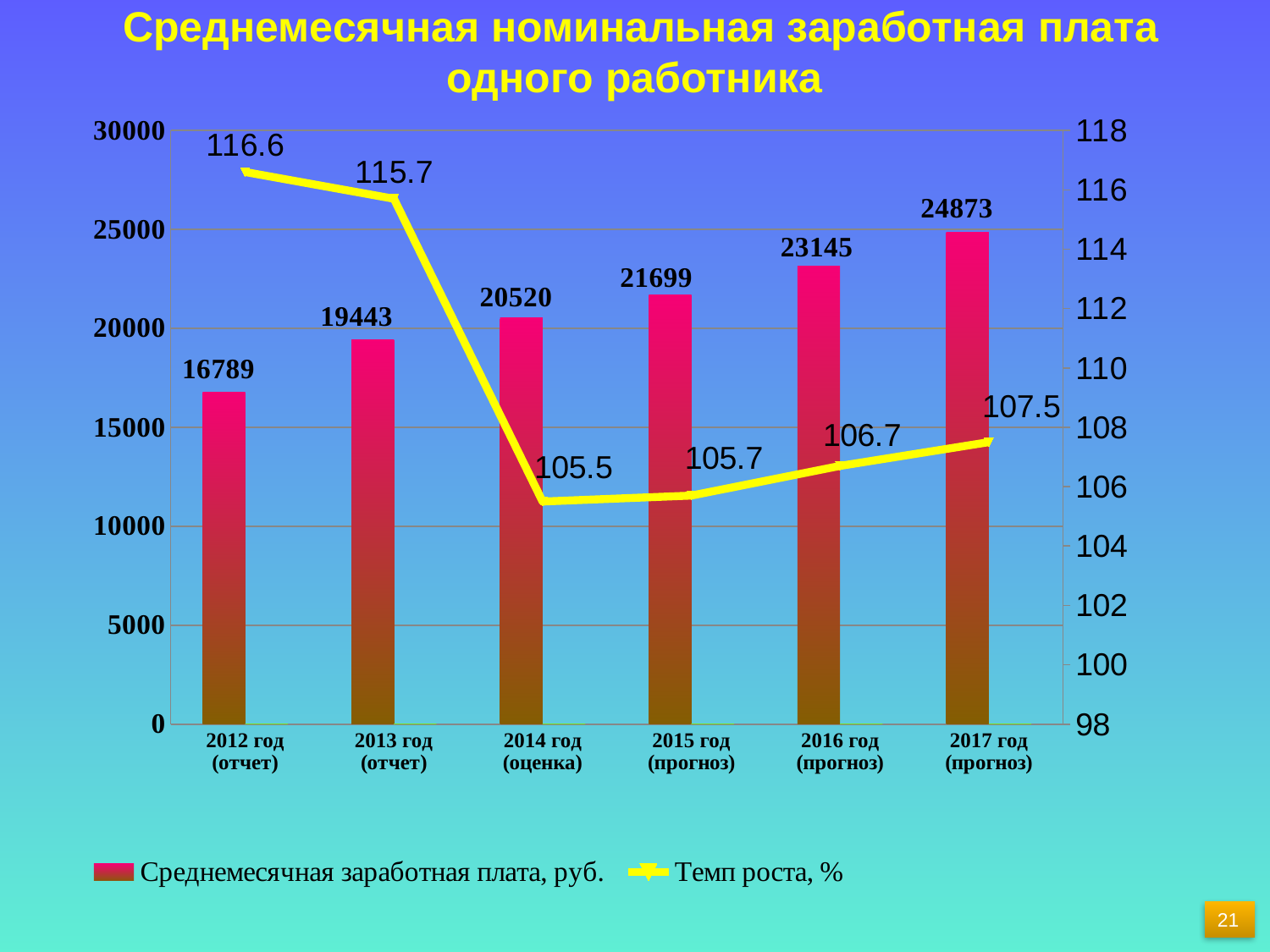
What is the growth rate (Темп роста, %) for 2012 год (отчет)? 116.6 What is the average monthly wage (Среднемесячная заработная плата, руб.) for 2014 год (оценка)? 20520 What is the growth rate (Темп роста, %) for 2016 год (прогноз)? 106.7 How many years are shown on the x axis? 6 What colour is the line for Темп роста, %? yellow Does the average monthly wage rise or fall from 2012 to 2017? rise Which is larger, the average monthly wage for 2015 год (прогноз) or for 2016 год (прогноз)? 2016 год (прогноз) What is the difference in average monthly wage between 2017 год (прогноз) and 2012 год (отчет)? 8084 How many series does the legend list? 2 Which year has the lowest growth rate (Темп роста, %)? 2014 год (оценка) Which year has the highest average monthly wage? 2017 год (прогноз) What is the difference in growth rate between 2012 год (отчет) and 2013 год (отчет)? 0.9